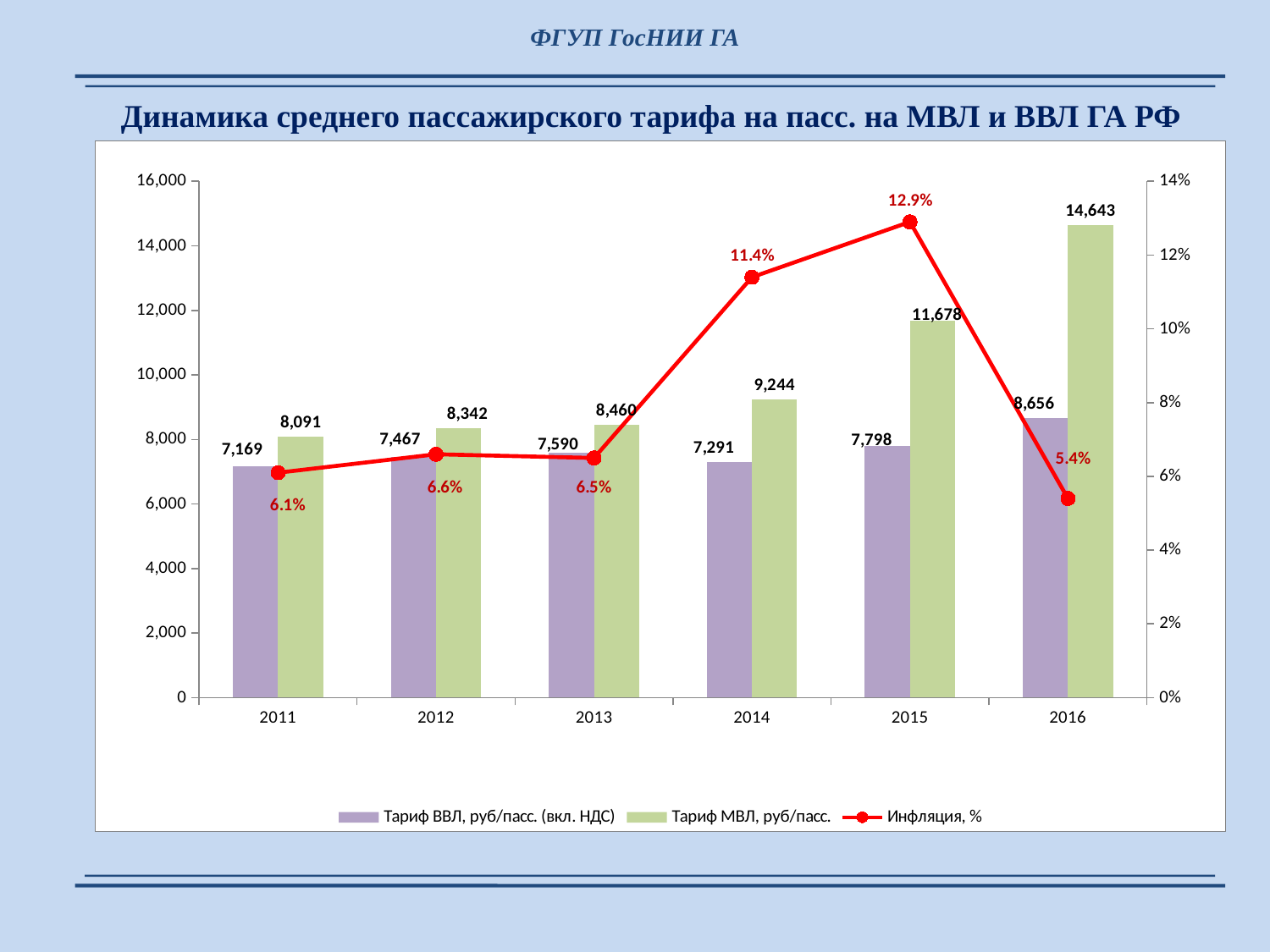
What is the difference between Тариф МВЛ and Тариф ВВЛ in 2016? 5,987 What is the value of Тариф МВЛ, руб/пасс. for 2016? 14,643 Is the value of Тариф МВЛ, руб/пасс. for 2015 greater or less than 10,000? greater Which is larger in 2014: Тариф МВЛ, руб/пасс. or Тариф ВВЛ, руб/пасс. (вкл. НДС)? Тариф МВЛ, руб/пасс. In which year is Инфляция, % the lowest? 2016 In which year is Тариф ВВЛ, руб/пасс. (вкл. НДС) the lowest? 2011 In which year is Тариф МВЛ, руб/пасс. the highest? 2016 What is the value of Тариф ВВЛ, руб/пасс. (вкл. НДС) for 2011? 7,169 What is the Инфляция, % value for 2015? 12.9% How many years are shown on the x axis? 6 How many series does the legend list? 3 Does Тариф МВЛ, руб/пасс. rise or fall from 2011 to 2016? rise